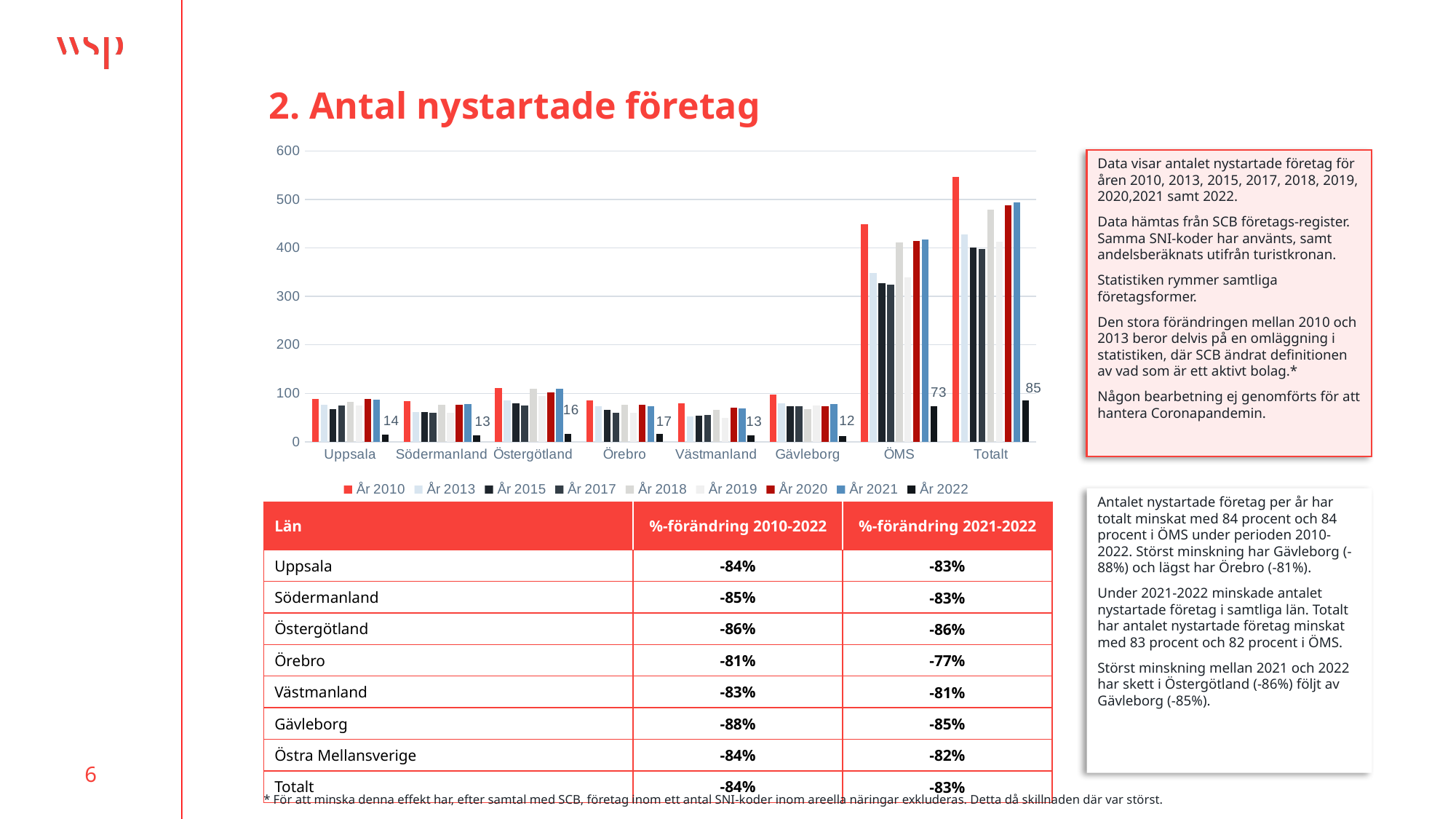
What is the value for År 2022 in ÖMS? 73 What is the value for År 2022 in Uppsala? 14 For År 2022, which is larger: Östergötland or Örebro? Örebro What is the value for År 2022 in Totalt? 85 How many series does the chart legend list? 9 Is the value for År 2010 in ÖMS greater or less than 400? greater Is the value for År 2010 in Totalt greater or less than 500? greater What kind of chart is shown on the slide? bar chart How many categories are shown on the x axis of the chart? 8 What is the difference between the År 2022 values for Totalt and ÖMS? 12 Which category has the highest value for År 2022? Totalt Which category has the lowest value for År 2022? Gävleborg